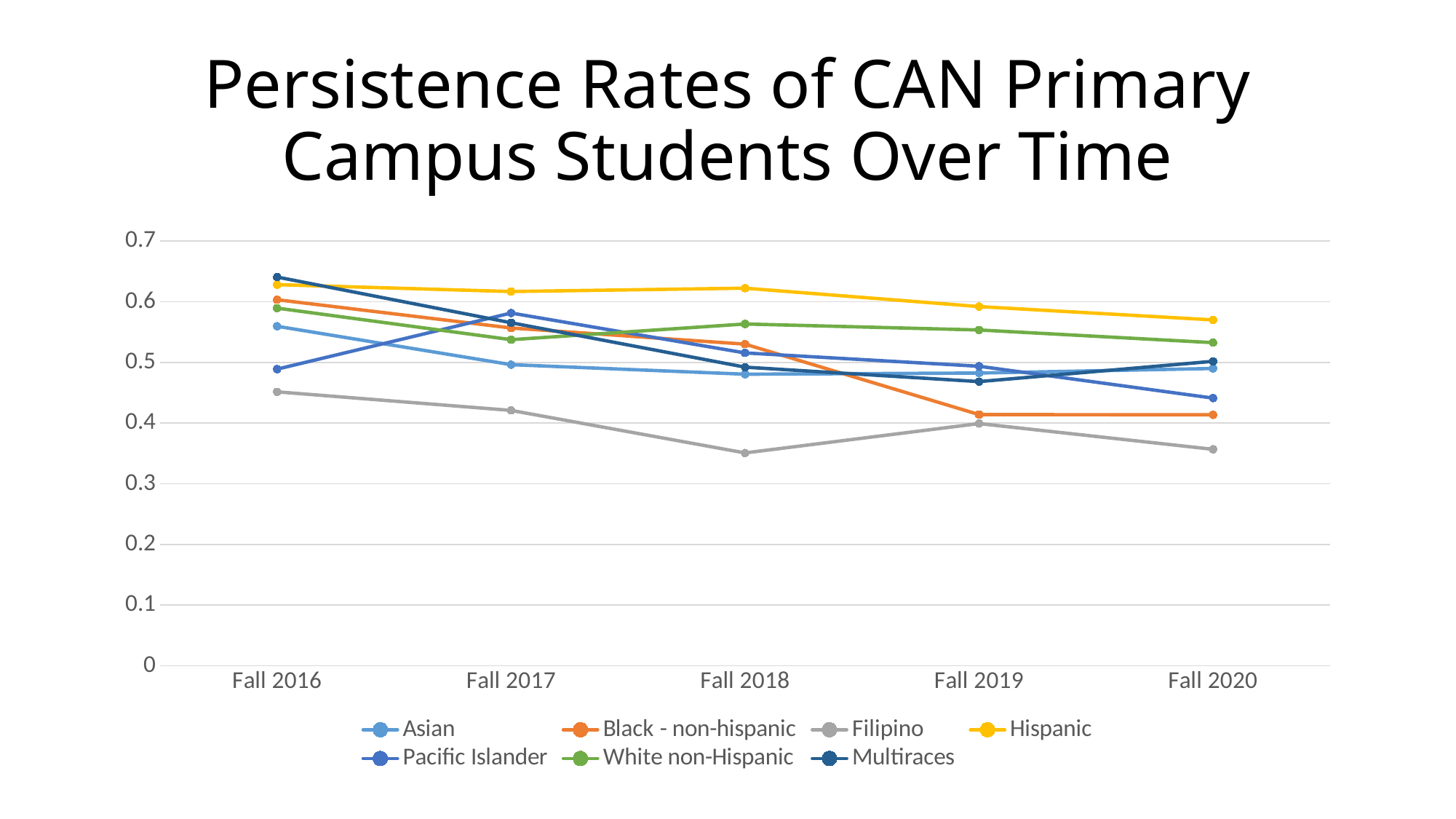
Does the Hispanic persistence rate rise or fall from Fall 2016 to Fall 2020? fall What kind of chart is shown on the slide? line chart Is the Hispanic persistence rate in Fall 2016 greater or less than 0.6? greater In Fall 2020, which is higher: the Hispanic or the Filipino persistence rate? Hispanic In Fall 2019, which is higher: the White non-Hispanic or the Black - non-hispanic persistence rate? White non-Hispanic Which group has the lowest persistence rate in Fall 2018? Filipino What is the title of the chart? Persistence Rates of CAN Primary Campus Students Over Time How many series does the legend list? 7 Is the Black - non-hispanic persistence rate in Fall 2019 greater or less than 0.5? less How many time points are shown along the x axis? 5 Which group has the highest persistence rate in Fall 2020? Hispanic Is the Filipino persistence rate in Fall 2018 greater or less than 0.4? less